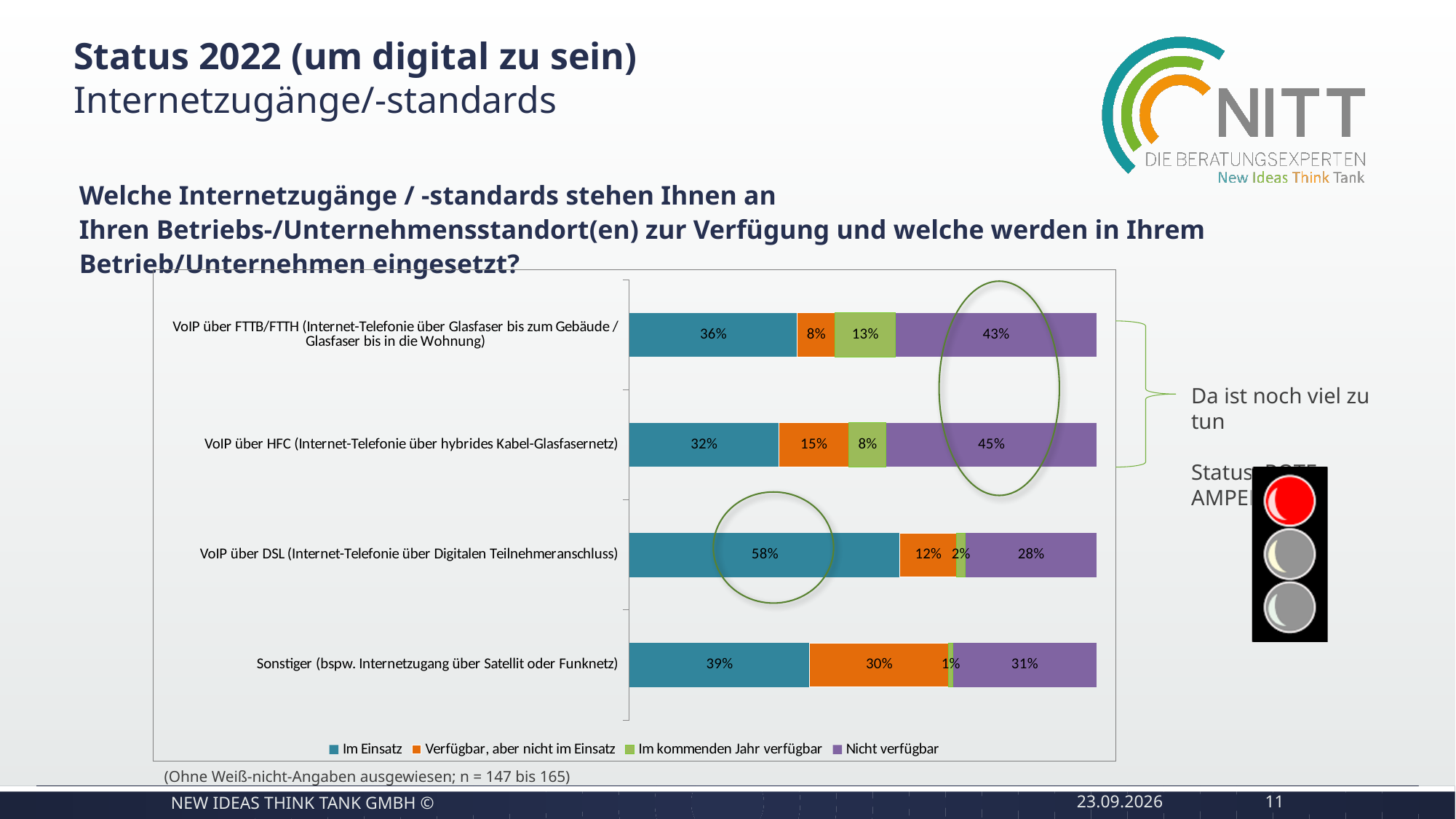
Which is larger: the 'Im Einsatz' value for VoIP über FTTB/FTTH or for VoIP über HFC? VoIP über FTTB/FTTH Which series is shown in purple in the chart? Nicht verfügbar How many series does the legend list? 4 What is the 'Verfügbar, aber nicht im Einsatz' value for Sonstiger (bspw. Internetzugang über Satellit oder Funknetz)? 30% What is the difference between the 'Nicht verfügbar' values for VoIP über HFC and VoIP über DSL? 17% What is the 'Im Einsatz' value for VoIP über DSL? 58% What is the 'Im kommenden Jahr verfügbar' value for VoIP über FTTB/FTTH? 13% How many categories (internet access types) are shown in the chart? 4 What is the 'Nicht verfügbar' value for VoIP über HFC? 45% What kind of chart is shown on the slide? Stacked bar chart Which category has the lowest 'Im kommenden Jahr verfügbar' value? Sonstiger (bspw. Internetzugang über Satellit oder Funknetz) Which category has the highest 'Im Einsatz' value? VoIP über DSL